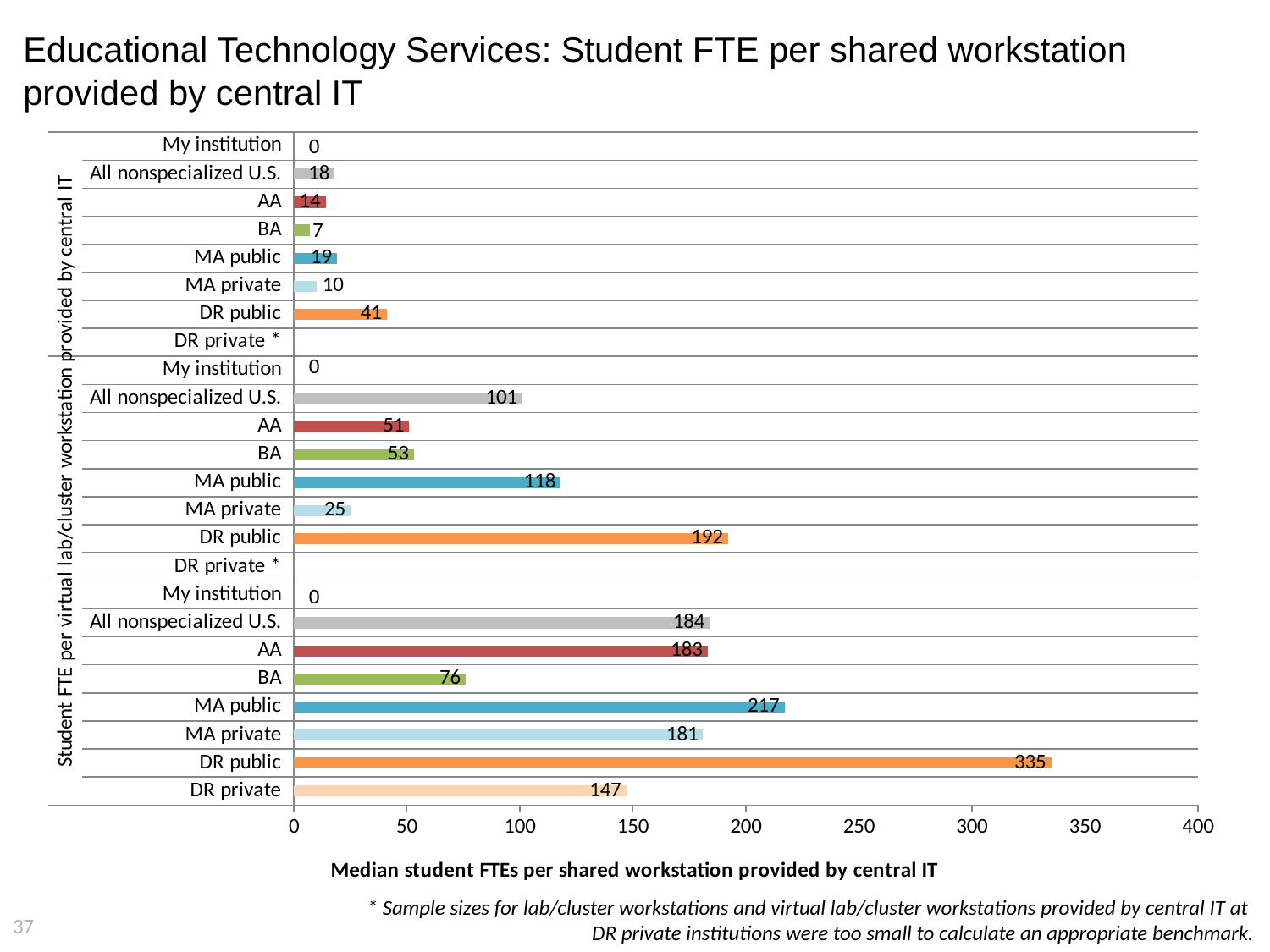
What is the maximum value shown on the horizontal axis? 400 In the bottom group of bars, which is larger, MA public or MA private? MA public In the middle group of bars, what is the difference between MA public and MA private? 93 In the bottom group of bars, which category has the highest value? DR public In the bottom group of bars, what is the value for DR private? 147 In the bottom group of bars, what is the value for DR public? 335 What type of chart is shown on the slide? bar chart In the top group of bars, what is the value for DR public? 41 In the top group of bars, which category has the lowest non-zero value? BA In the middle group of bars, what is the difference between DR public and All nonspecialized U.S.? 91 In the middle group of bars, what is the value for MA public? 118 What is the label of the horizontal axis? Median student FTEs per shared workstation provided by central IT